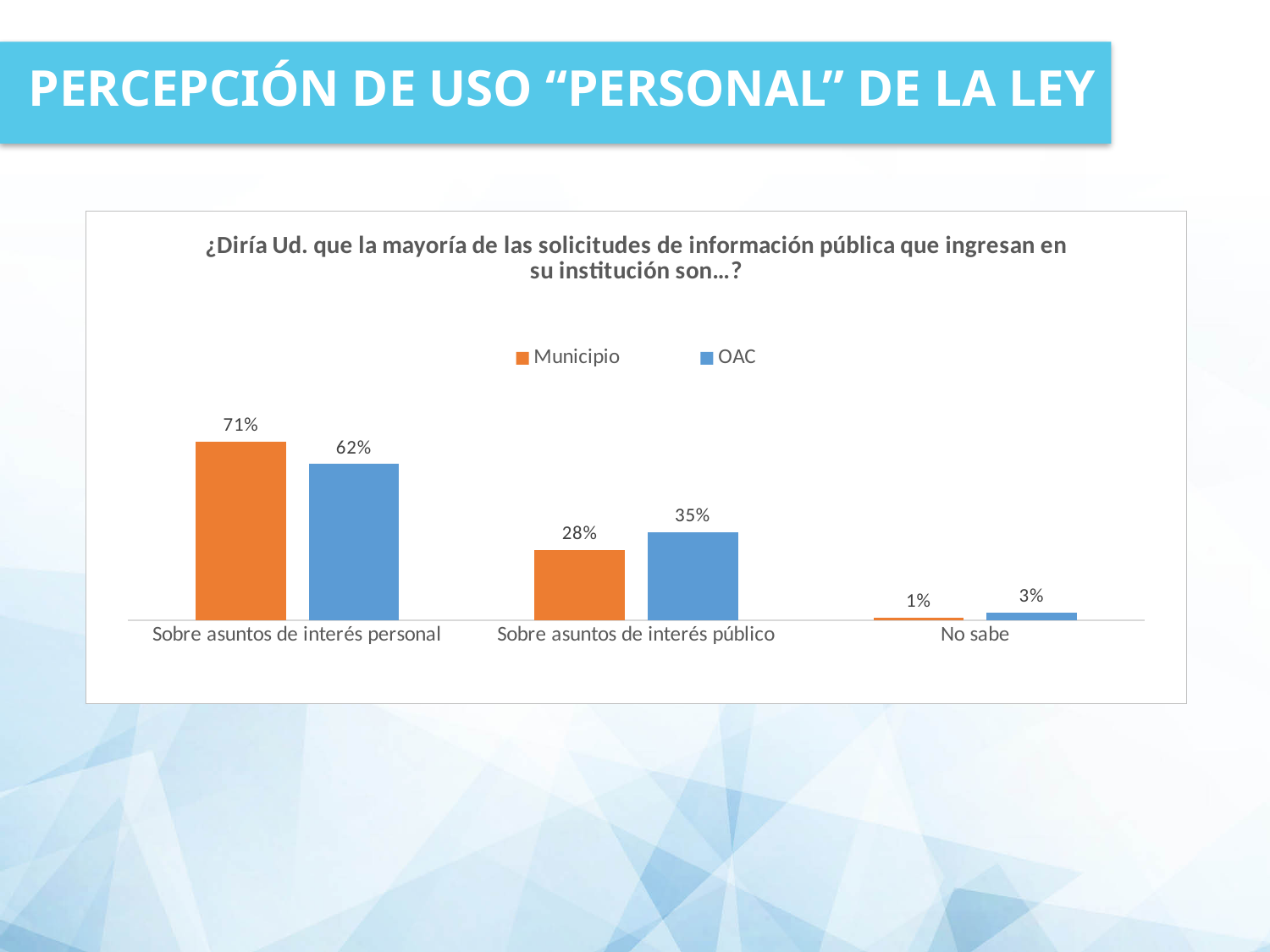
How many categories are shown on the x axis? 3 How many series does the legend list? 2 What is the OAC value for "No sabe"? 3% Which category has the lowest OAC value? No sabe What is the OAC value for "Sobre asuntos de interés público"? 35% For "Sobre asuntos de interés público", which series has the larger value, Municipio or OAC? OAC What kind of chart is shown on the slide? Bar chart Which category has the highest Municipio value? Sobre asuntos de interés personal Which colour represents the Municipio series? Orange What is the difference between the OAC and Municipio values for "Sobre asuntos de interés público"? 7% What is the Municipio value for "Sobre asuntos de interés personal"? 71% What is the difference between the Municipio and OAC values for "Sobre asuntos de interés personal"? 9%